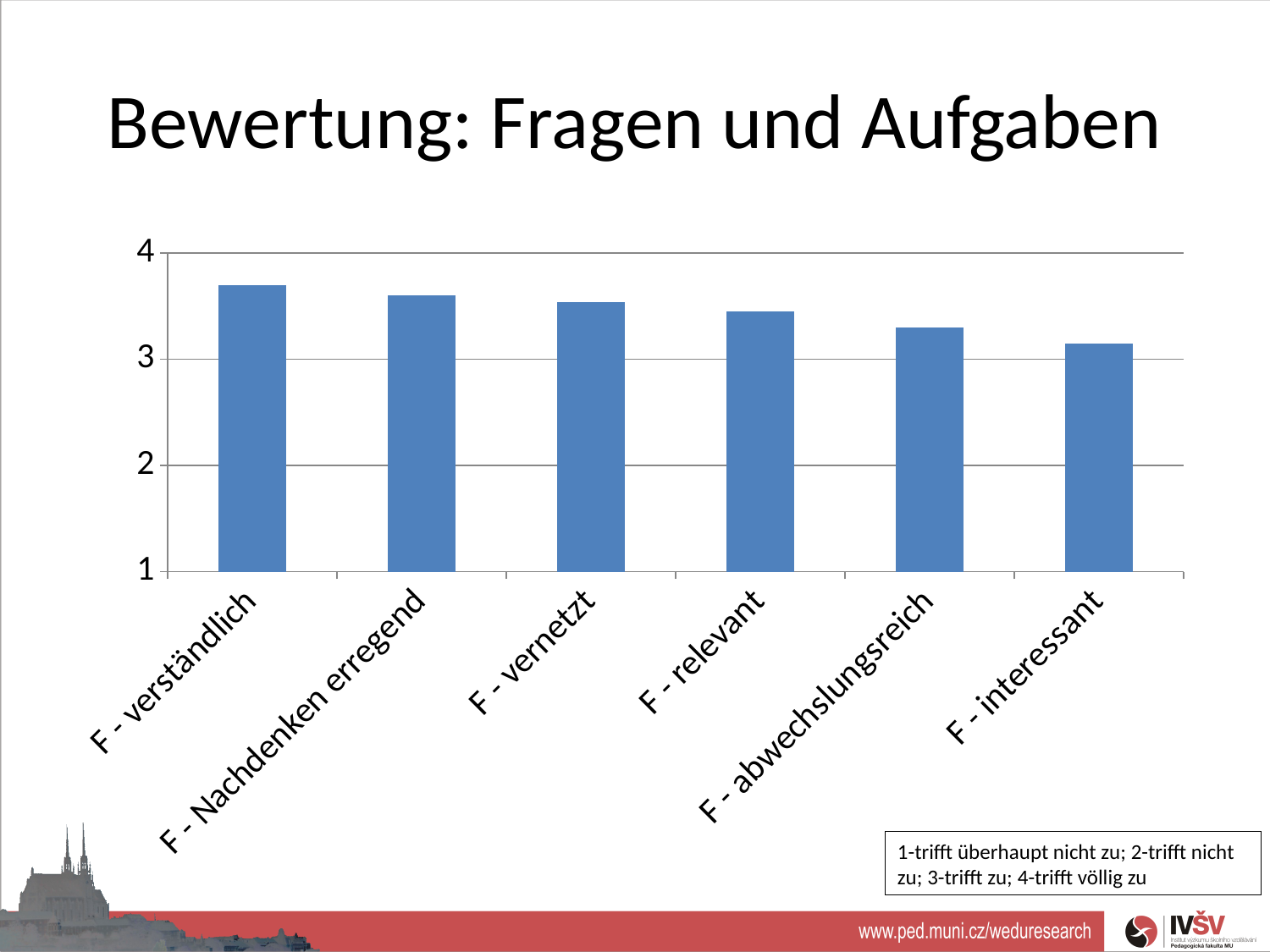
Which is larger, the value for F - verständlich or the value for F - interessant? F - verständlich Do the values rise or fall from left to right along the x axis? fall Is the value for F - verständlich greater or less than 4? less Is the value for F - abwechslungsreich greater or less than 3? greater What is the highest value shown on the y axis of the chart? 4 Is the value for F - interessant greater or less than 3? greater Which is larger, the value for F - Nachdenken erregend or the value for F - abwechslungsreich? F - Nachdenken erregend What kind of chart is shown on the slide? bar chart Which category has the highest value in the chart? F - verständlich Which category has the lowest value in the chart? F - interessant How many categories are shown on the x axis of the chart? 6 What is the title of the slide containing the chart? Bewertung: Fragen und Aufgaben